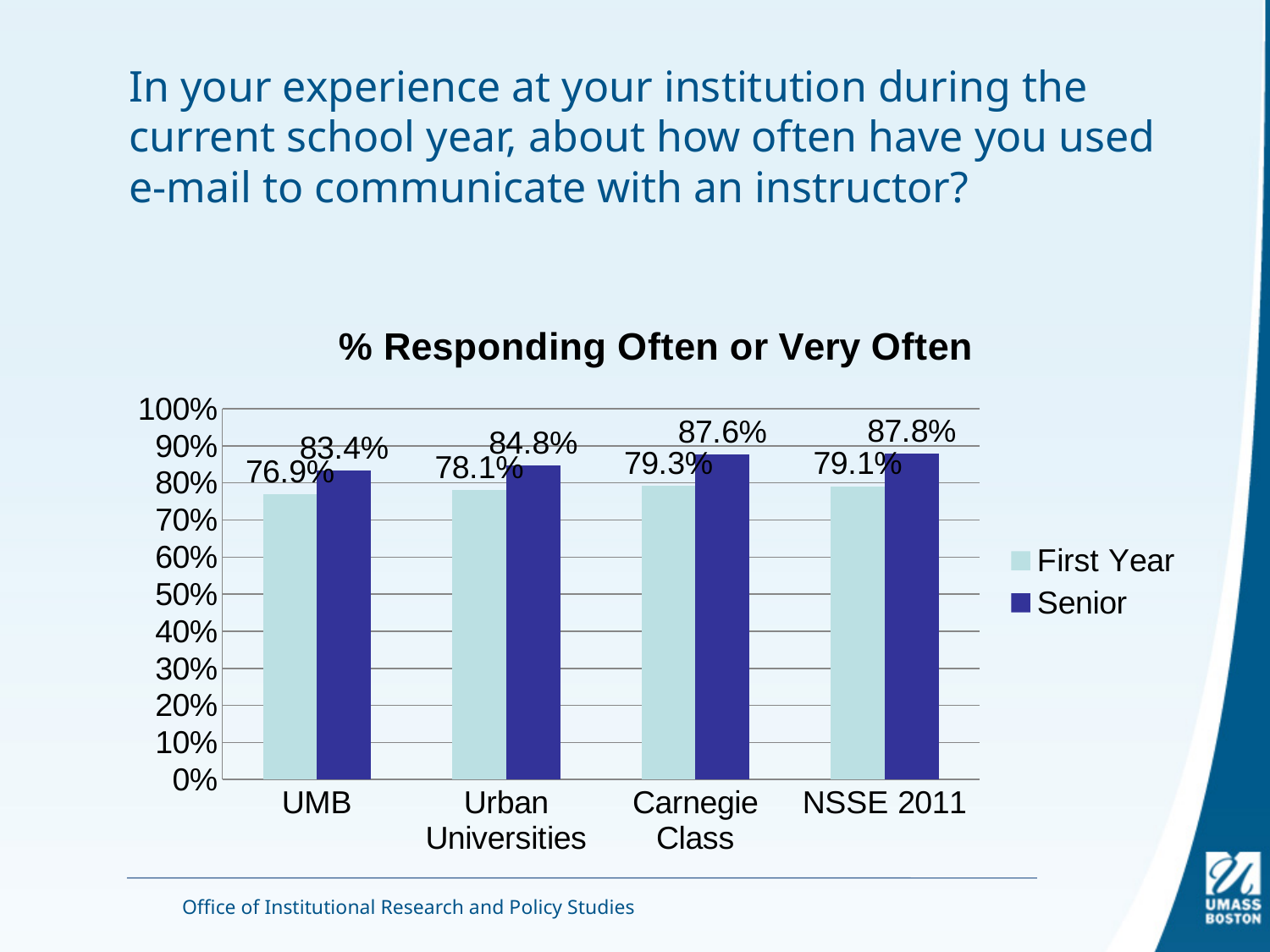
Is the Senior value for NSSE 2011 greater or less than 80%? greater Which category has the lowest First Year value? UMB What is the Senior value for Carnegie Class? 87.6% What is the First Year value for NSSE 2011? 79.1% Which category has the highest Senior value? NSSE 2011 What is the Senior value for Urban Universities? 84.8% What kind of chart is shown on the slide? Bar chart What is the difference between the Senior and First Year values for UMB? 6.5% Which is larger for Urban Universities, the First Year value or the Senior value? Senior How many categories are shown on the x axis? 4 How many series does the legend list? 2 What is the First Year value for UMB? 76.9%